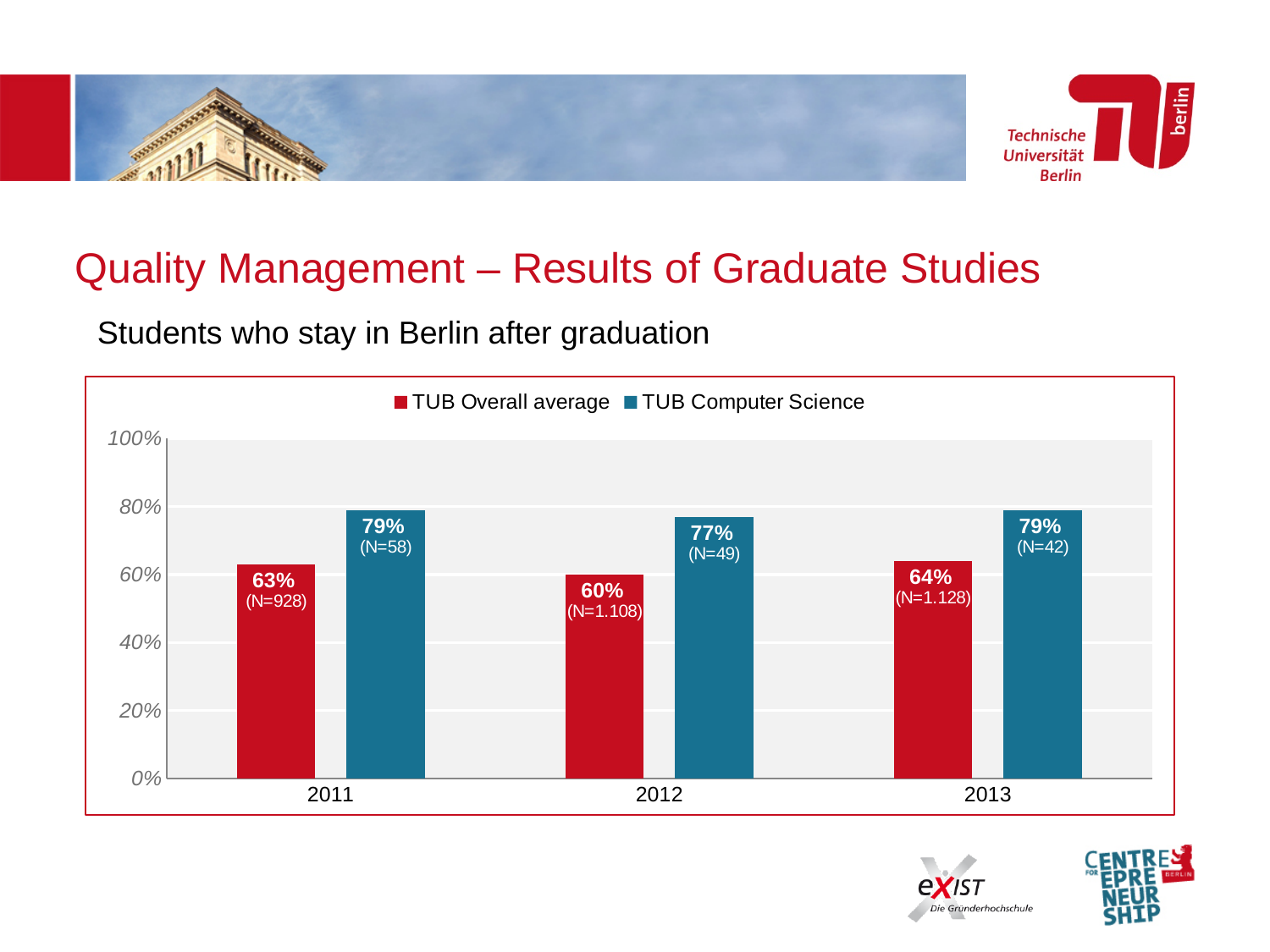
What is the difference between TUB Computer Science and TUB Overall average in 2012? 17 percentage points In which year is the TUB Computer Science value lowest? 2012 Which colour represents TUB Overall average in the chart? Red In which year is the TUB Overall average lowest? 2012 What is the value for TUB Overall average in 2013? 64% What is the value for TUB Overall average in 2011? 63% What is the value for TUB Computer Science in 2012? 77% How many years are shown on the x axis? 3 What kind of chart is shown on the slide? Bar chart How many series does the legend list? 2 What is the sample size (N) shown for TUB Overall average in 2012? N=1.108 Which is larger in 2013, TUB Overall average or TUB Computer Science? TUB Computer Science